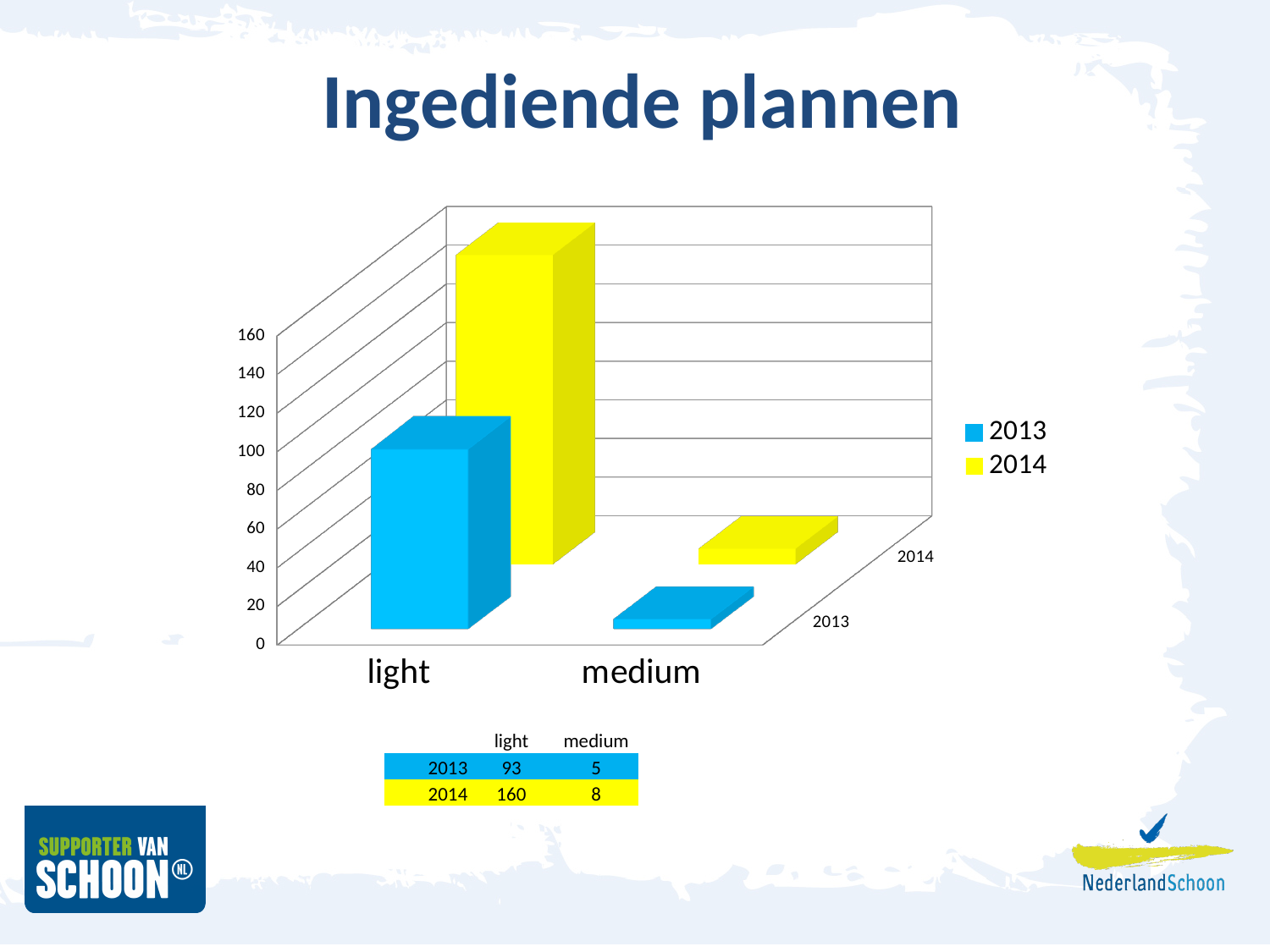
Which category has the highest value in 2014? light What is the title of the chart? Ingediende plannen Which category has the lowest value in 2013? medium What is the value for medium in 2013? 5 How many series does the legend list? 2 What is the value for light in 2014? 160 What is the difference between the light values for 2014 and 2013? 67 Which is larger, the light value for 2013 or the light value for 2014? 2014 What is the value for medium in 2014? 8 What kind of chart is shown on the slide? bar chart What is the value for light in 2013? 93 How many categories are shown on the x axis? 2